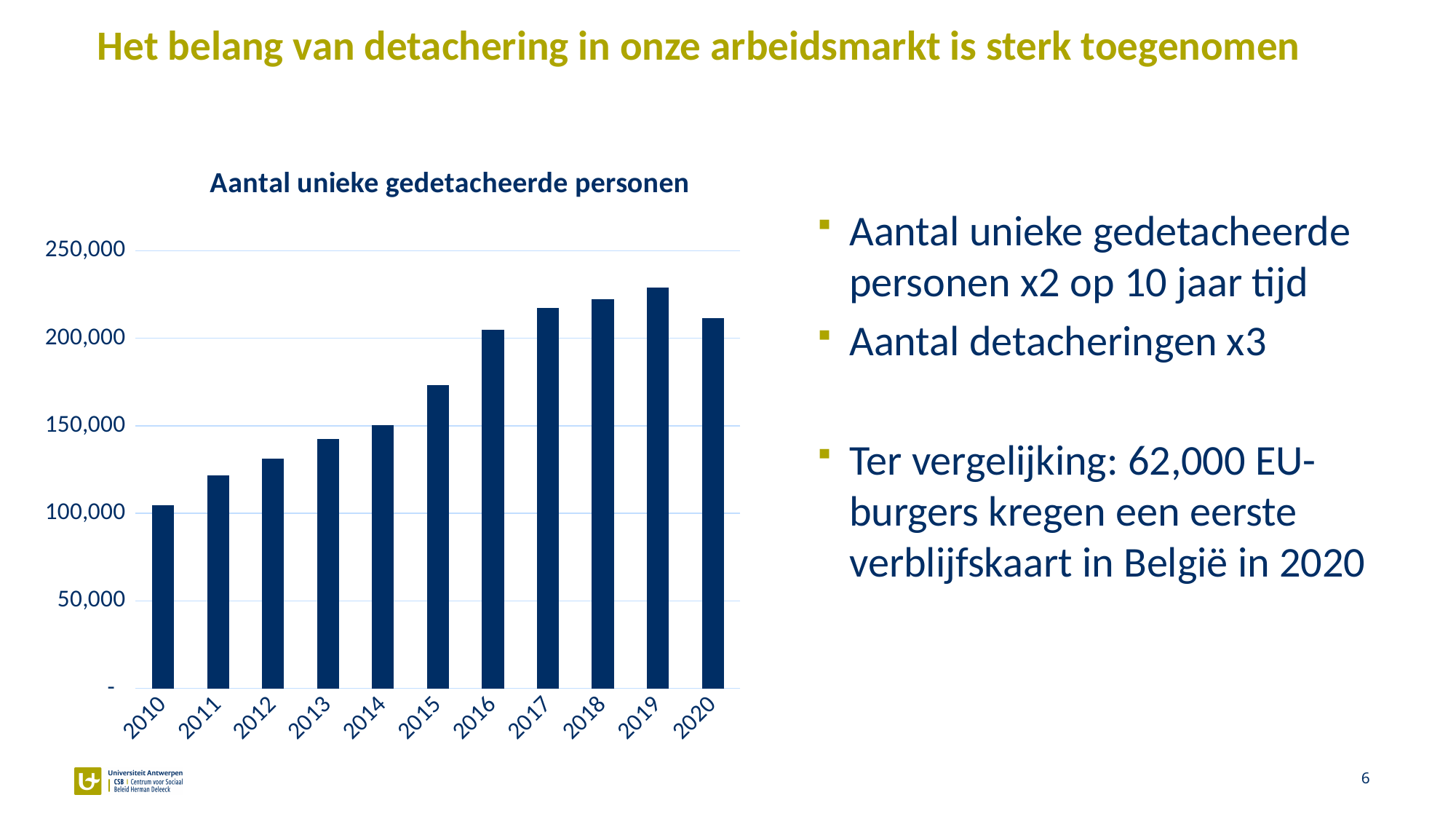
Is the value for 2015 greater or less than 150,000? greater Which year has the highest number of unique posted persons? 2019 Which year has the lowest number of unique posted persons? 2010 What is the title of the chart? Aantal unieke gedetacheerde personen How many years are shown on the x axis of the chart? 11 Which year has a higher value, 2013 or 2017? 2017 Which year has a higher value, 2019 or 2020? 2019 What kind of chart is shown on the slide? bar chart Is the value for 2019 greater or less than 200,000? greater Do the values rise or fall from 2010 to 2019? rise Is the value for 2010 greater or less than 150,000? less